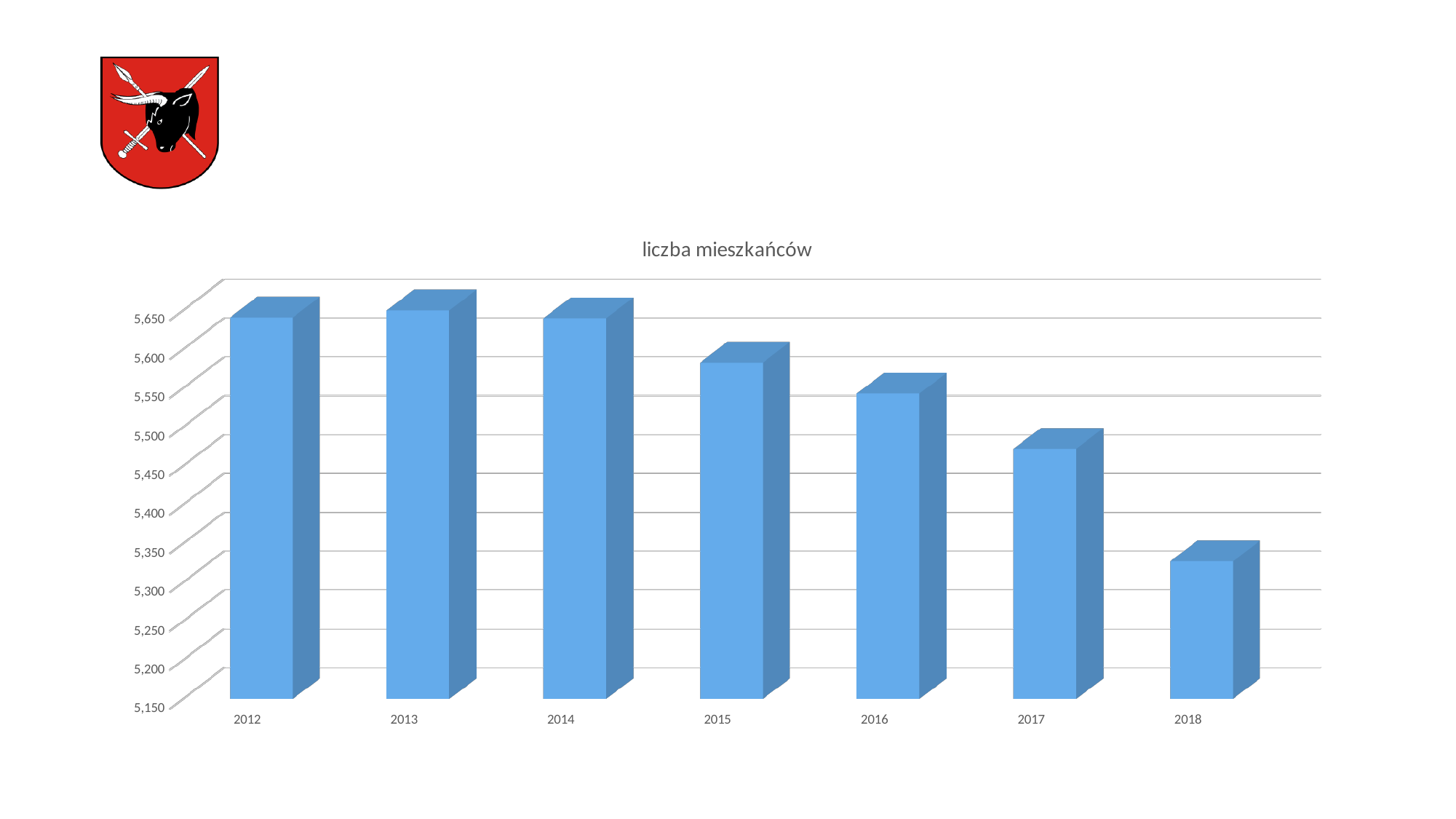
Is the value for 2017 greater or less than 5,500? less Is the value for 2018 greater or less than 5,350? less How many years are shown on the x axis of the chart? 7 What kind of chart is shown on the slide? bar chart Which is larger, the value for 2012 or the value for 2018? 2012 Is the value for 2016 greater or less than 5,500? greater Which year has the lowest value in the chart? 2018 Which is larger, the value for 2015 or the value for 2016? 2015 What is the title of the chart? liczba mieszkańców Do the values generally rise or fall from 2012 to 2018? fall